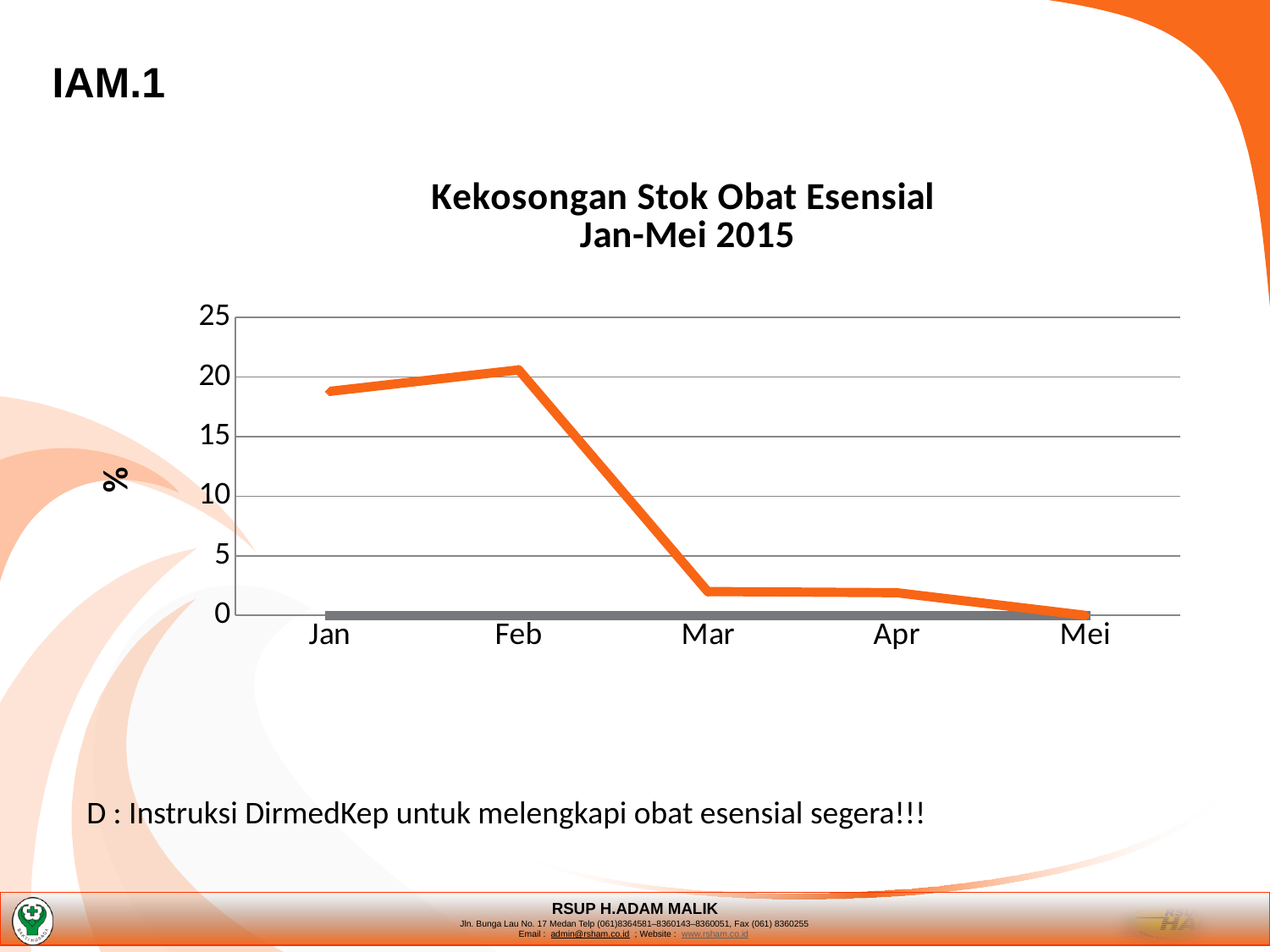
What is the title of the chart? Kekosongan Stok Obat Esensial Jan-Mei 2015 How many months are plotted on the x axis of the chart? 5 Is the value for Mar greater or less than 5? less Do the values generally rise or fall from Feb to Mei? fall What is the label on the y axis of the chart? % Which month has the highest value in the chart? Feb Which month has the lowest value in the chart? Mei Which is larger, the value for Jan or the value for Mar? Jan What kind of chart is shown on the slide? line chart Is the value for Apr greater or less than 5? less Is the value for Jan greater or less than 15? greater